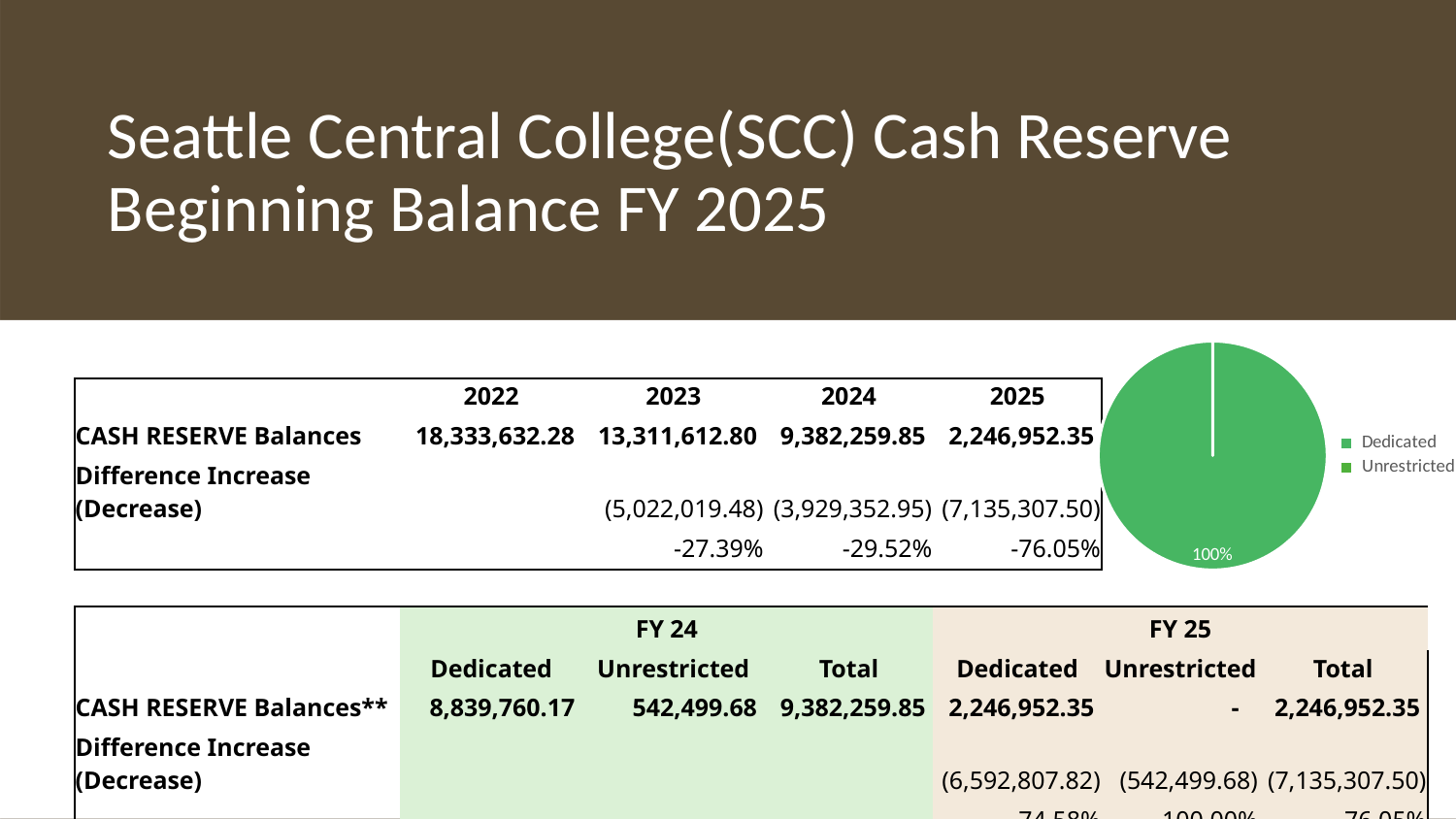
What colour is used for the Dedicated category in the pie chart? green What kind of chart is shown on the right side of the slide? pie chart What are the two legend entries of the pie chart? Dedicated and Unrestricted Which is larger in the pie chart, the Dedicated slice or the Unrestricted slice? Dedicated What share of the pie chart does the Dedicated slice take up? 100% How many entries does the legend of the pie chart list? 2 Is the share of the Dedicated slice in the pie chart greater or less than 50%? greater Which category has the smallest slice in the pie chart? Unrestricted What percentage label is printed on the pie chart? 100% Which category has the largest slice in the pie chart? Dedicated